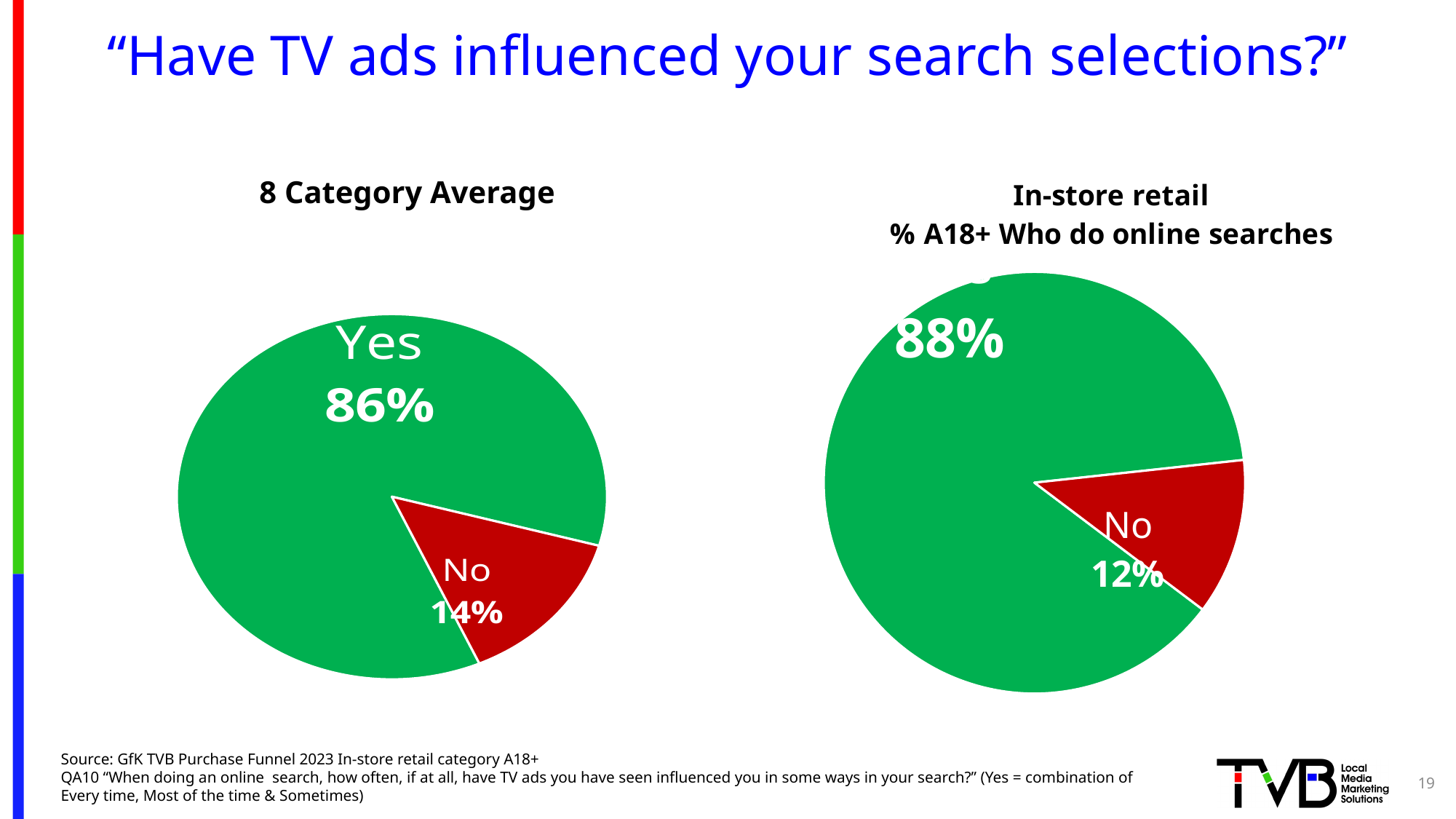
In the '8 Category Average' pie chart, what is the difference between the Yes and No percentages? 72% In the '8 Category Average' pie chart, what percentage answered No? 14% In the '8 Category Average' pie chart, which response has the largest share? Yes In the 'In-store retail' pie chart, what percentage is shown for the green slice? 88% What type of chart is used on this slide? Pie chart In the '8 Category Average' pie chart, what percentage answered Yes? 86% What is the difference between the No percentage in the '8 Category Average' chart and the No percentage in the 'In-store retail' chart? 2% In the '8 Category Average' pie chart, which response has the smallest share? No Is the No share larger in the '8 Category Average' chart or the 'In-store retail' chart? 8 Category Average In the 'In-store retail' pie chart, what percentage answered No? 12% How many slices does the '8 Category Average' pie chart have? 2 What colour is the No slice in the 'In-store retail' pie chart? Red